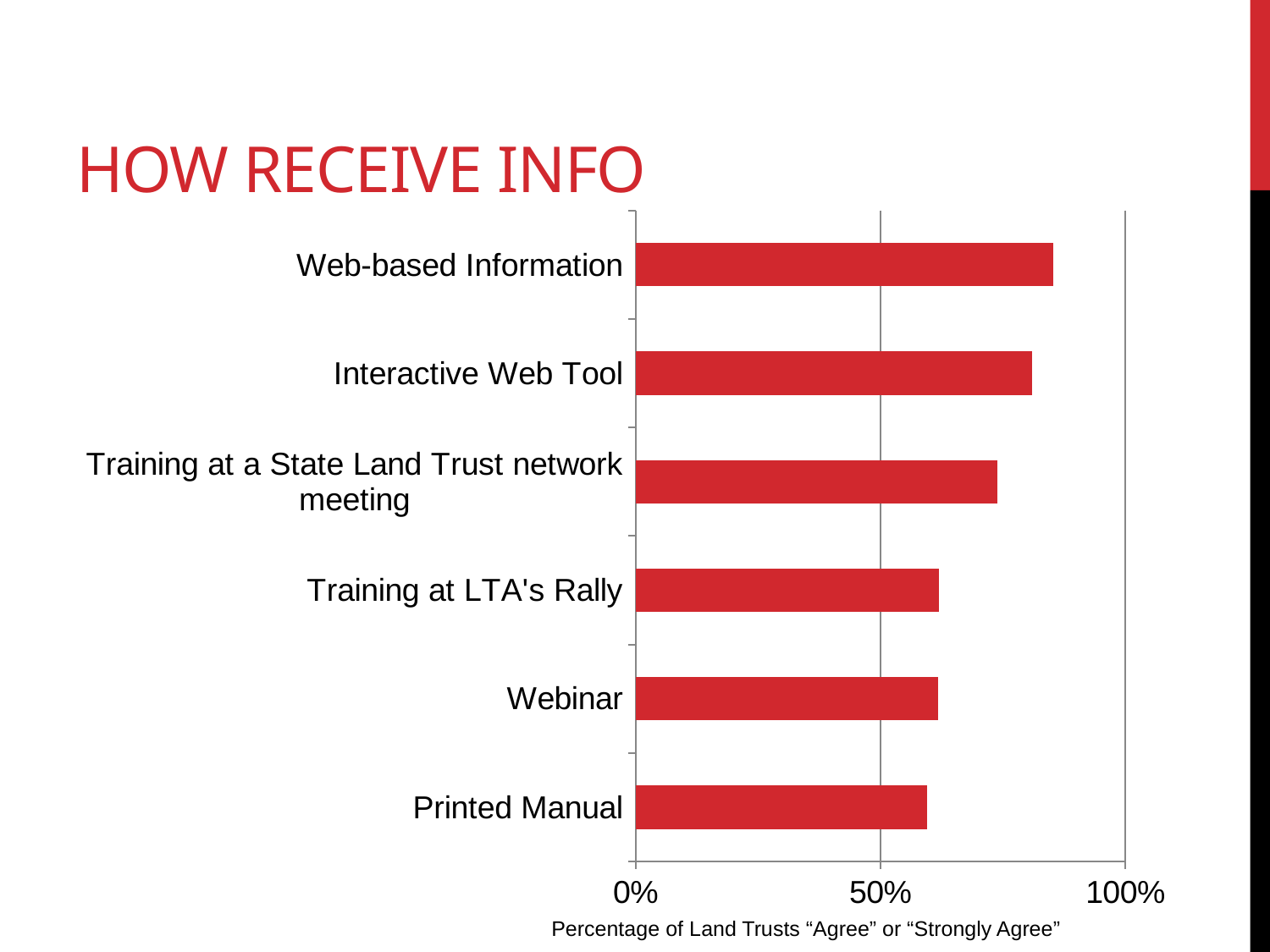
What kind of chart is shown on the slide? bar chart Which is larger, the value for Interactive Web Tool or the value for Training at LTA's Rally? Interactive Web Tool Is the value for Webinar greater or less than 100%? less Is the value for Web-based Information greater or less than 50%? greater How many categories are shown in the chart? 6 Which category has the highest value in the chart? Web-based Information What is the label on the horizontal axis of the chart? Percentage of Land Trusts "Agree" or "Strongly Agree" Is the value for Interactive Web Tool greater or less than 100%? less Which is larger, the value for Web-based Information or the value for Printed Manual? Web-based Information What is the title of the slide containing the chart? HOW RECEIVE INFO Which is larger, the value for Training at a State Land Trust network meeting or the value for Webinar? Training at a State Land Trust network meeting